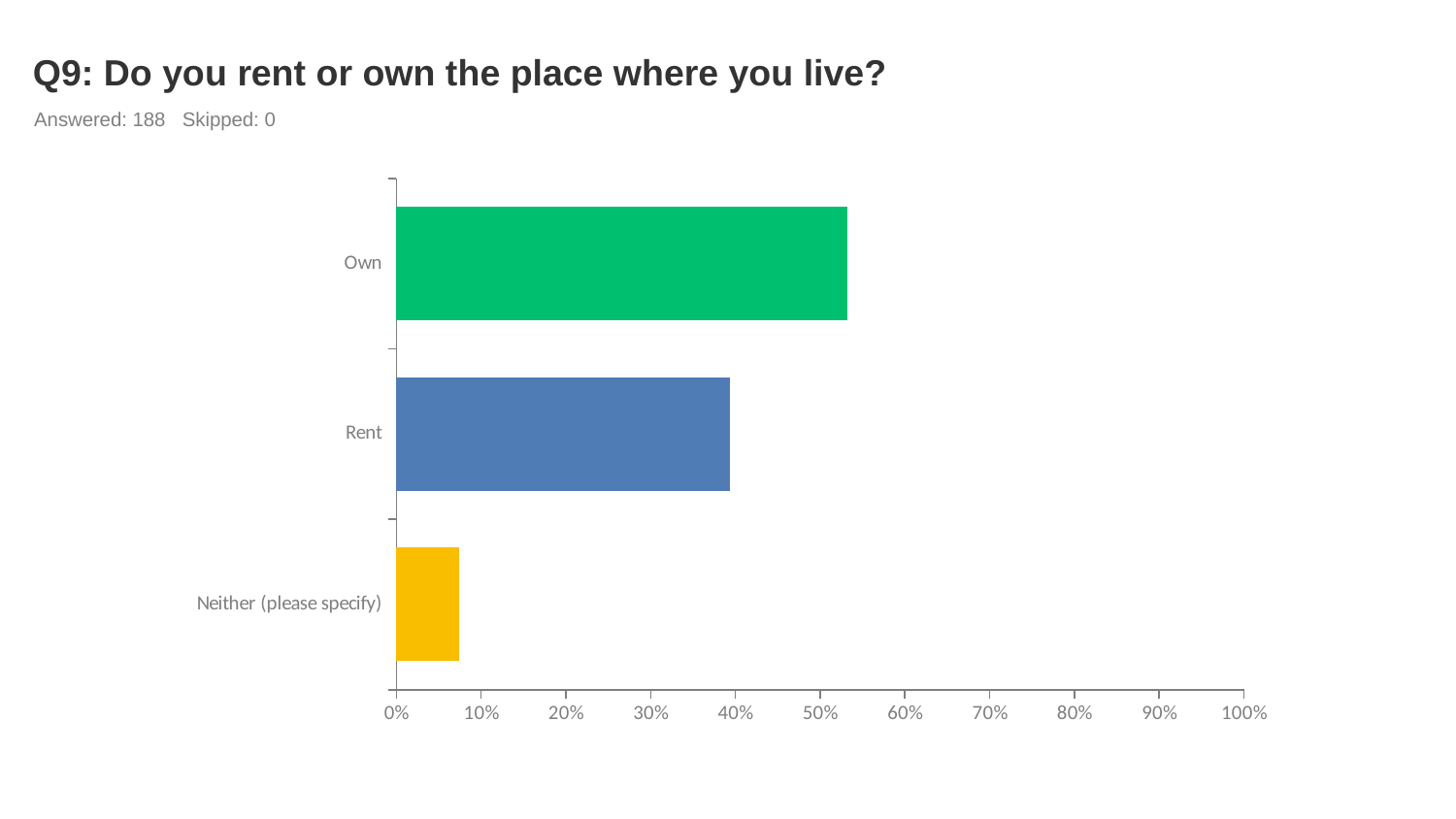
Is the value for Neither (please specify) greater or less than 10%? less Which is larger, the value for Rent or the value for Neither (please specify)? Rent Which category has the highest value? Own Which category has the lowest value? Neither (please specify) How many respondents answered the question according to the slide? 188 Is the value for Own greater or less than 60%? less Which is larger, the value for Own or the value for Rent? Own Is the value for Own greater or less than 50%? greater How many categories does the chart show? 3 What is the title of the chart? Q9: Do you rent or own the place where you live? What kind of chart is shown on the slide? bar chart